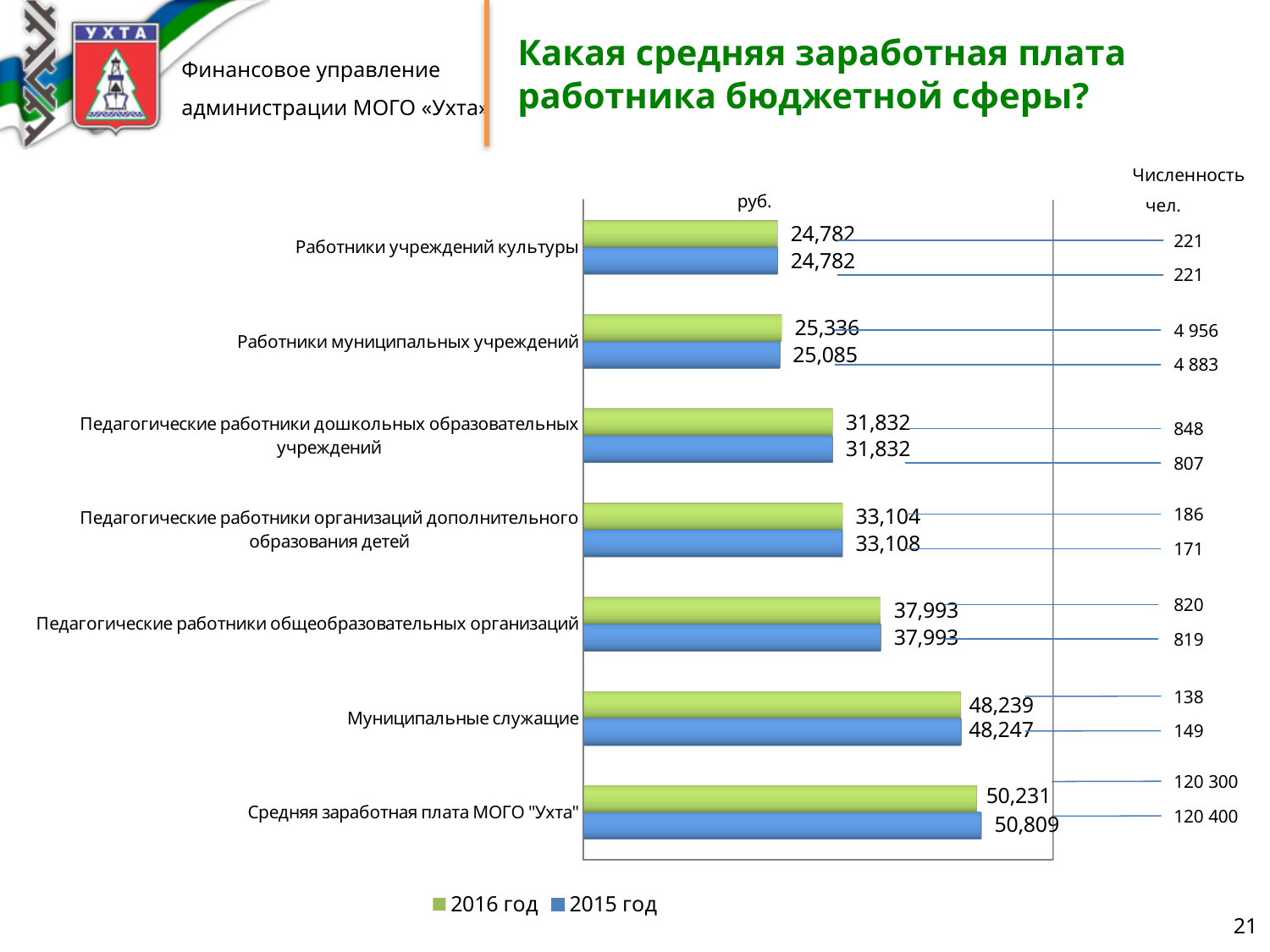
What is the difference between the 2015 год and 2016 год values for Муниципальные служащие? 8 For Работники муниципальных учреждений, which series has the larger value, 2016 год or 2015 год? 2016 год Which category has the highest 2016 год value? Средняя заработная плата МОГО "Ухта" What is the 2015 год value for Педагогические работники организаций дополнительного образования детей? 33,108 What are the legend entries of the chart? 2016 год, 2015 год What is the 2016 год value for Муниципальные служащие? 48,239 How many series does the legend list? 2 How many categories are shown on the chart? 7 What is the difference between the 2015 год and 2016 год values for Средняя заработная плата МОГО "Ухта"? 578 What is the 2015 год value for Работники муниципальных учреждений? 25,085 What kind of chart is shown on the slide? Bar chart Which category has the lowest 2015 год value? Работники учреждений культуры